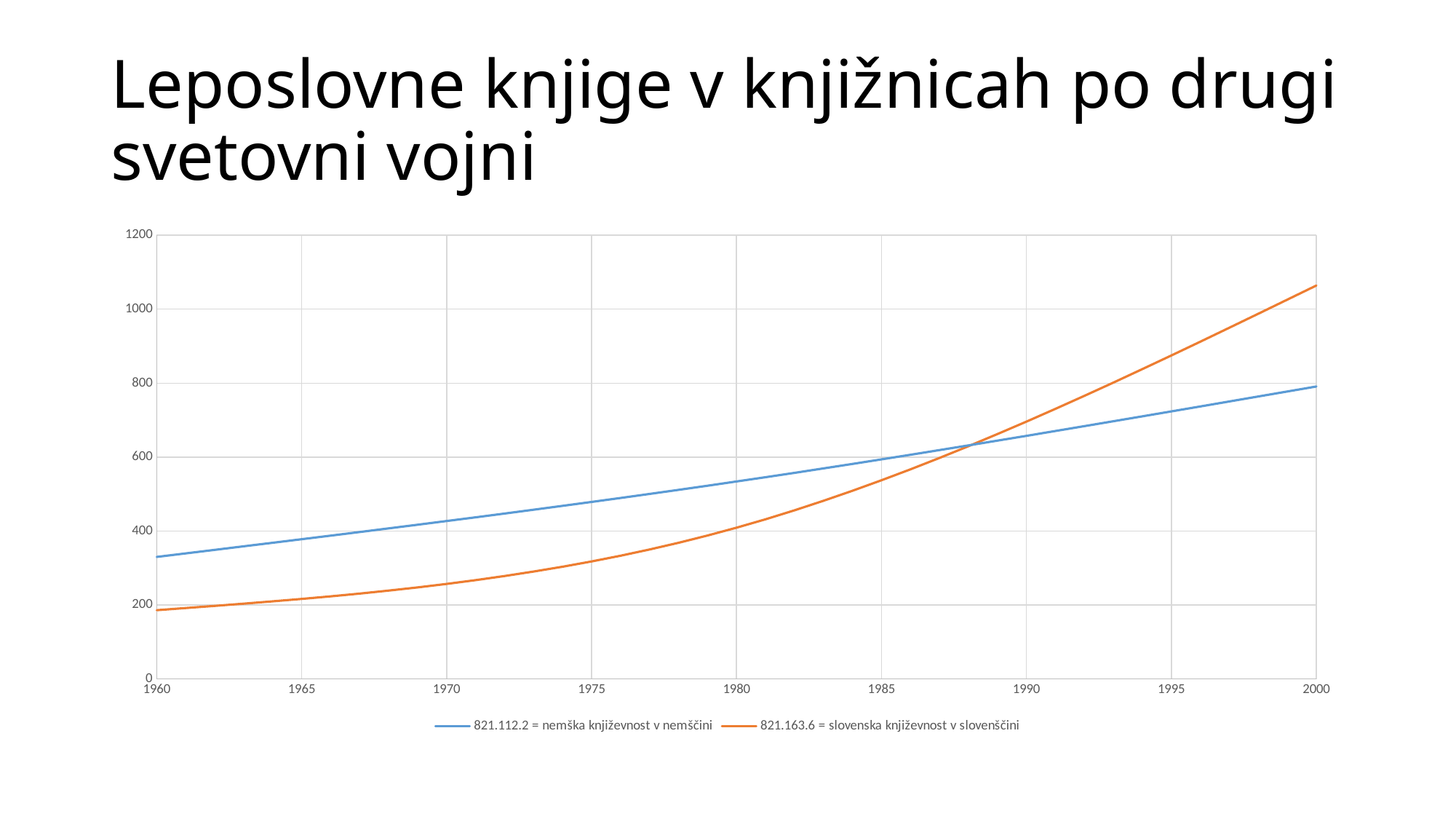
In 1970, which series has the larger value: '821.112.2 = nemška književnost v nemščini' or '821.163.6 = slovenska književnost v slovenščini'? 821.112.2 = nemška književnost v nemščini What kind of chart is shown on the slide? line chart Which colour is used for the series '821.163.6 = slovenska književnost v slovenščini'? orange Does the value for '821.163.6 = slovenska književnost v slovenščini' rise or fall from 1960 to 2000? rise Does the value for '821.112.2 = nemška književnost v nemščini' rise or fall from 1960 to 2000? rise Is the value for '821.163.6 = slovenska književnost v slovenščini' in 1990 greater or less than 600? greater In 2000, which series has the larger value: '821.112.2 = nemška književnost v nemščini' or '821.163.6 = slovenska književnost v slovenščini'? 821.163.6 = slovenska književnost v slovenščini Is the value for '821.112.2 = nemška književnost v nemščini' in 1980 greater or less than 400? greater Is the value for '821.112.2 = nemška književnost v nemščini' in 1960 greater or less than 400? less What is the title of the slide's chart? Leposlovne knjige v knjižnicah po drugi svetovni vojni How many series does the legend list? 2